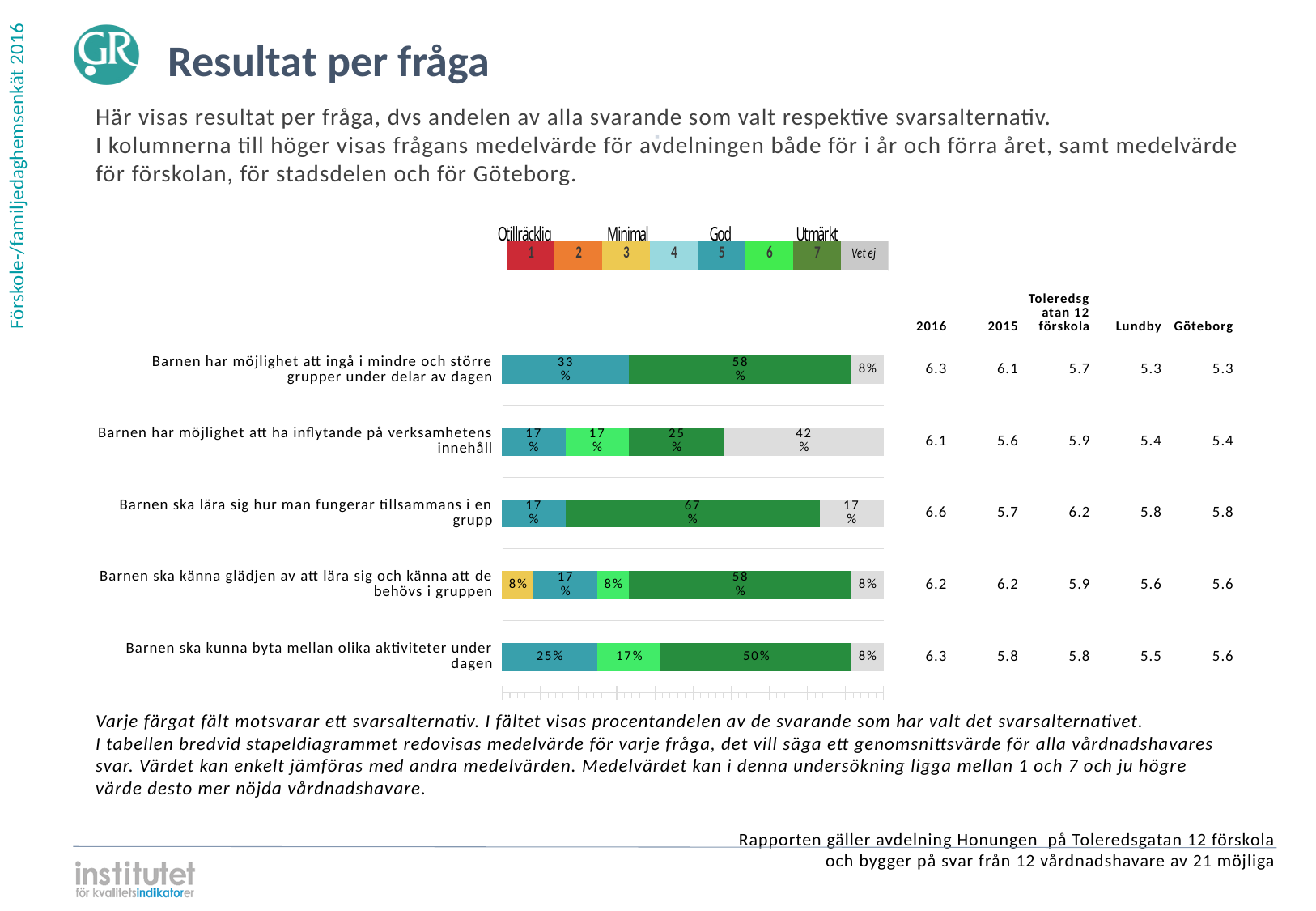
What is the Göteborg mean value shown for 'Barnen ska kunna byta mellan olika aktiviteter under dagen'? 5.6 What is the sum of the 25%, 17% and 50% segments for 'Barnen ska kunna byta mellan olika aktiviteter under dagen'? 92% Which question has the smallest dark green (7, Utmärkt) segment? Barnen har möjlighet att ha inflytande på verksamhetens innehåll Which question has the largest dark green (7, Utmärkt) segment? Barnen ska lära sig hur man fungerar tillsammans i en grupp What kind of chart is shown on the slide? Stacked bar chart How many questions (categories) are plotted in the bar chart? 5 Which response option does the grey segment at the right end of each bar represent, according to the legend? Vet ej What percentage of respondents chose 'Vet ej' for 'Barnen har möjlighet att ha inflytande på verksamhetens innehåll'? 42% What is the largest segment value shown in the bar for 'Barnen ska lära sig hur man fungerar tillsammans i en grupp'? 67% What is the difference between the 58% segment and the 33% segment in the bar for 'Barnen har möjlighet att ingå i mindre och större grupper under delar av dagen'? 25 percentage points Is the 50% segment for 'Barnen ska kunna byta mellan olika aktiviteter under dagen' larger or smaller than the 58% segment for 'Barnen ska känna glädjen av att lära sig och känna att de behövs i gruppen'? Smaller What is the 2016 mean value shown for 'Barnen ska lära sig hur man fungerar tillsammans i en grupp'? 6.6